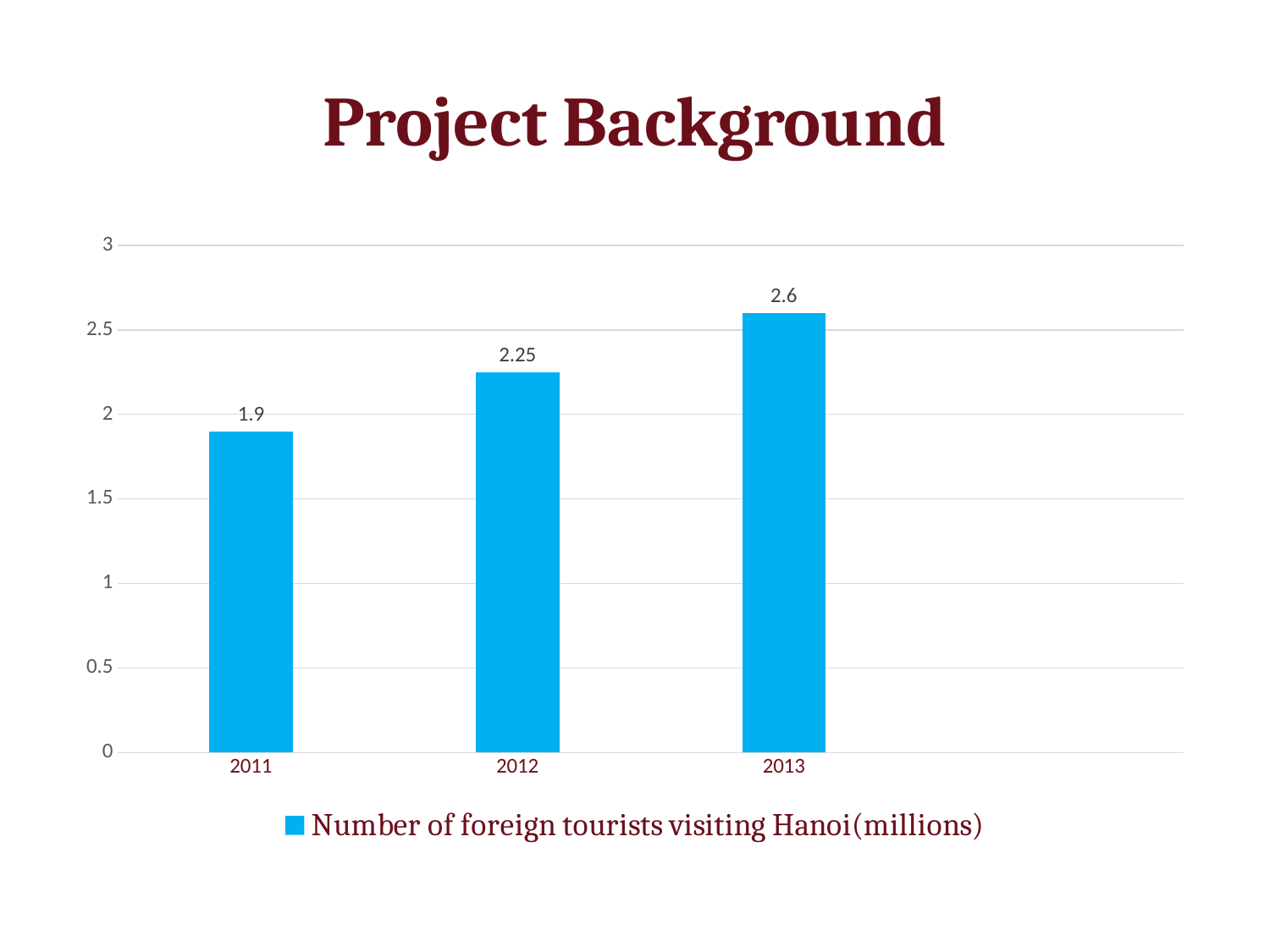
Which year has a larger value, 2012 or 2013? 2013 Is the value for 2011 greater or less than 2? less Which year has the lowest number of foreign tourists visiting Hanoi? 2011 What is the difference between the values for 2012 and 2011? 0.35 What is the number of foreign tourists visiting Hanoi (millions) in 2011? 1.9 Which year has the highest number of foreign tourists visiting Hanoi? 2013 What is the difference between the values for 2013 and 2011? 0.7 Do the values rise or fall from 2011 to 2013? Rise What is the number of foreign tourists visiting Hanoi (millions) in 2013? 2.6 What kind of chart is shown on the slide? Bar chart How many years are shown on the x axis of the chart? 3 What is the number of foreign tourists visiting Hanoi (millions) in 2012? 2.25